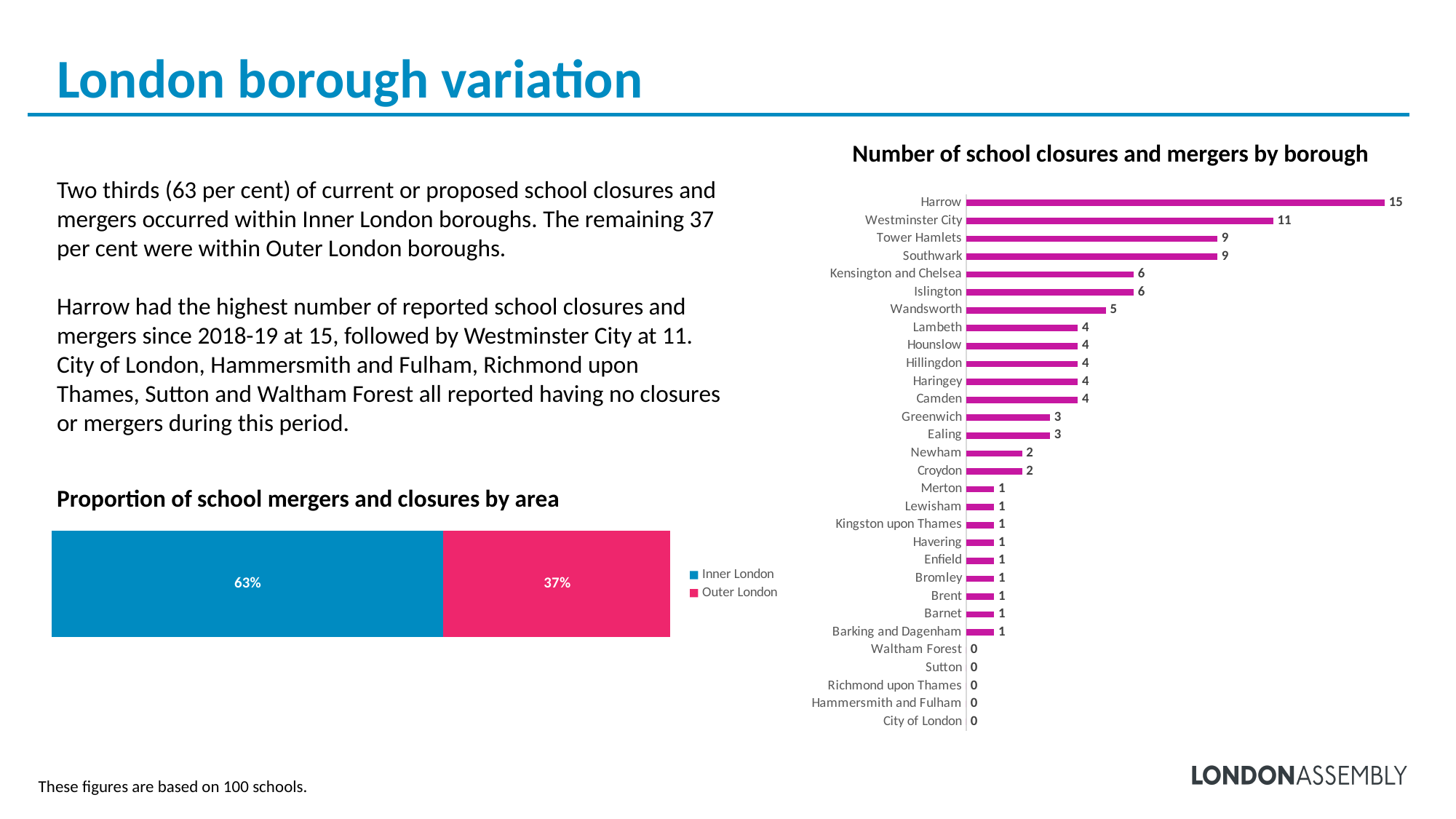
What kind of chart is 'Number of school closures and mergers by borough'? Bar chart In the 'Number of school closures and mergers by borough' chart, what is the value for Harrow? 15 In the 'Number of school closures and mergers by borough' chart, what is the value for Westminster City? 11 In the 'Number of school closures and mergers by borough' chart, what is the value for Sutton? 0 In the 'Number of school closures and mergers by borough' chart, what is the difference between Harrow and Westminster City? 4 In the 'Number of school closures and mergers by borough' chart, how many boroughs are listed? 30 In the 'Proportion of school mergers and closures by area' chart, what is the share for Inner London? 63% How many series does the legend of the 'Proportion of school mergers and closures by area' chart list? 2 In the 'Number of school closures and mergers by borough' chart, which borough has the highest value? Harrow In the 'Proportion of school mergers and closures by area' chart, what is the difference between Inner London and Outer London? 26% In the 'Number of school closures and mergers by borough' chart, which is larger, Islington or Greenwich? Islington In the 'Number of school closures and mergers by borough' chart, what is the value for Wandsworth? 5